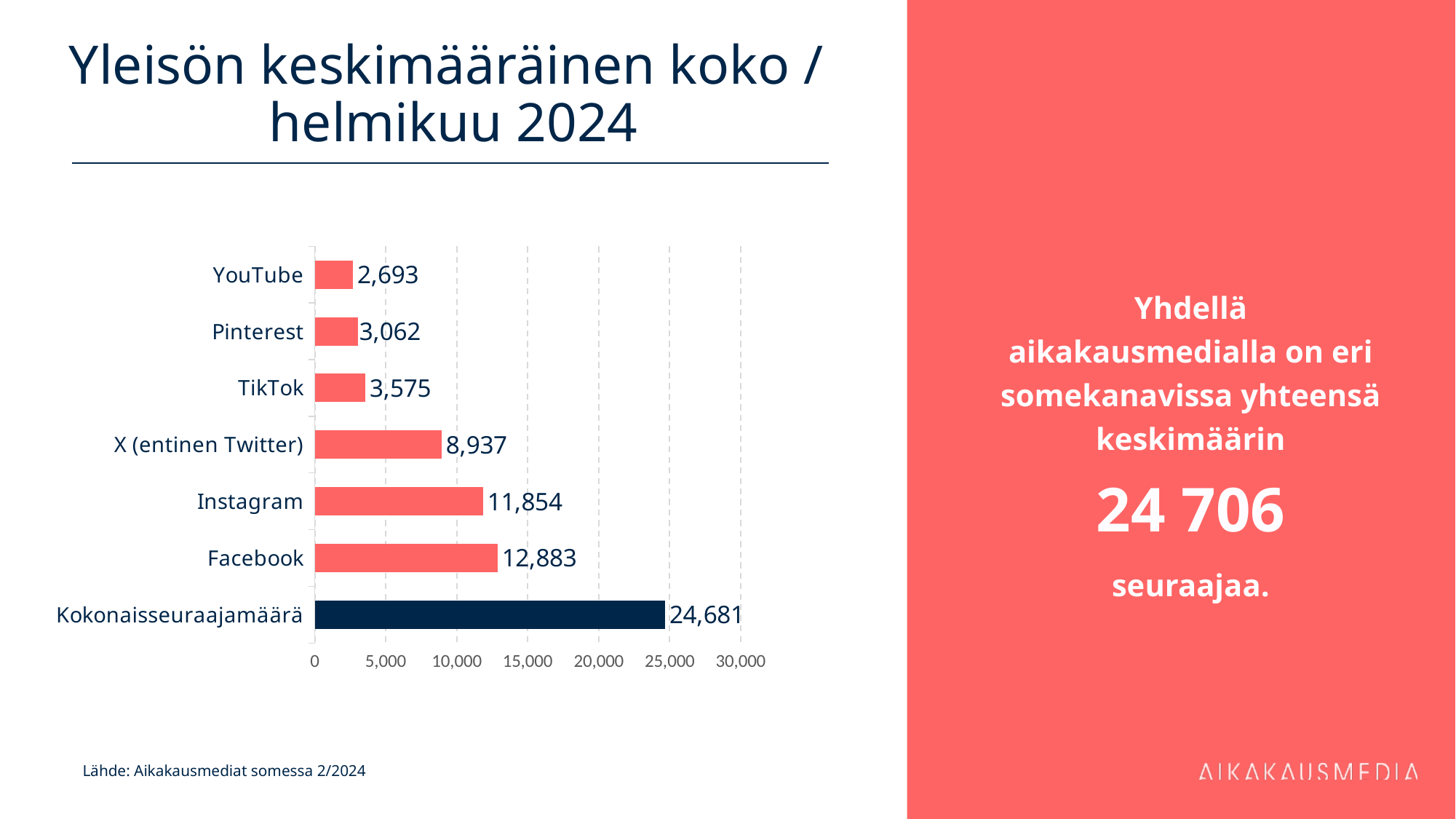
Which category has the lowest value? YouTube Which bar is shown in a different colour (dark navy) from the others? Kokonaisseuraajamäärä Is the value for Instagram greater or less than 10,000? greater How many categories are shown in the chart? 7 What is the value for Kokonaisseuraajamäärä? 24,681 Which is larger, the value for Instagram or the value for X (entinen Twitter)? Instagram Which category has the highest value? Kokonaisseuraajamäärä What is the value for Facebook? 12,883 What is the value for X (entinen Twitter)? 8,937 What kind of chart is shown on the slide? bar chart What is the difference between the values for TikTok and Pinterest? 513 What is the difference between the values for Facebook and Instagram? 1,029